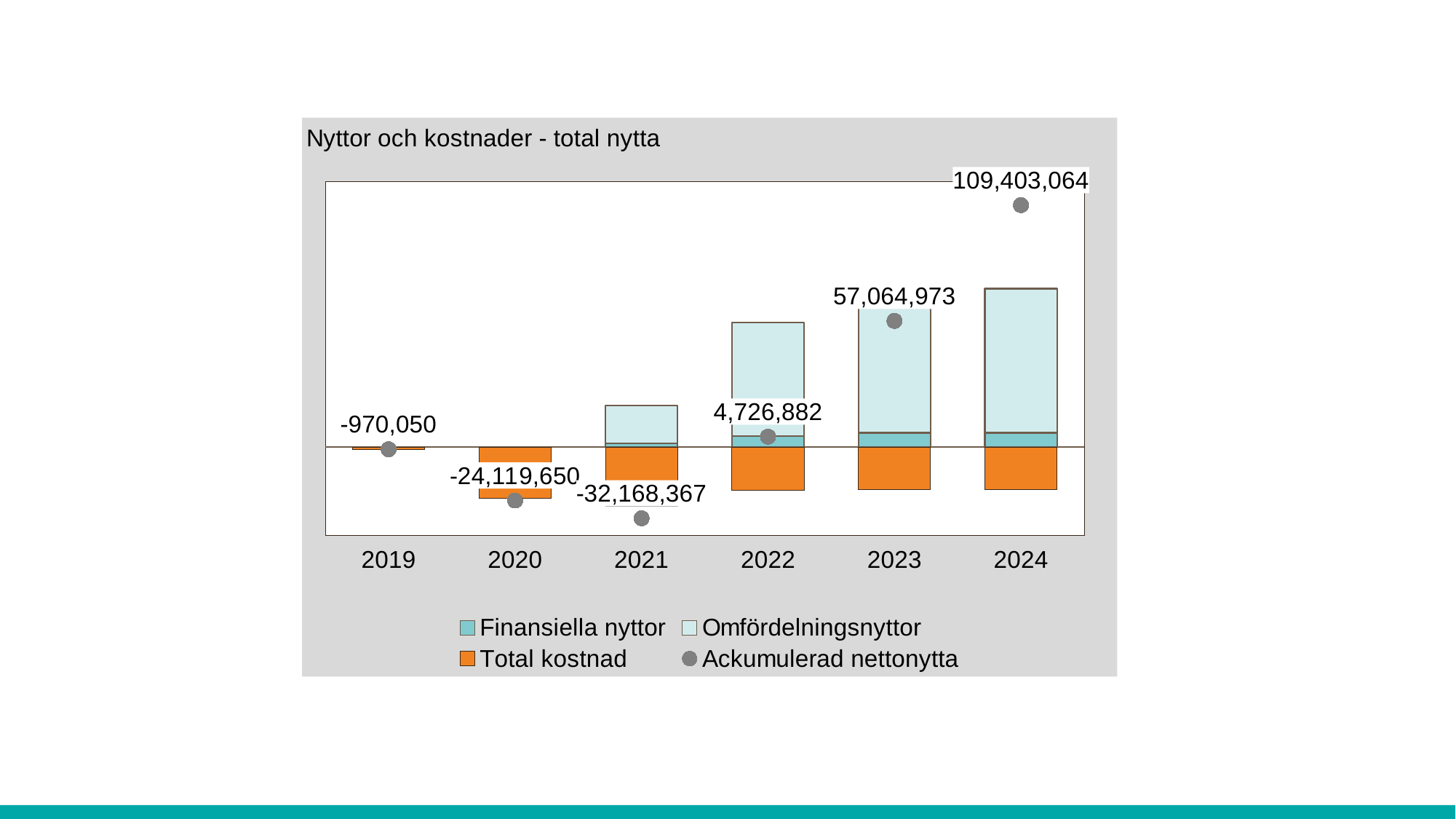
What is the value of Ackumulerad nettonytta for 2024? 109,403,064 What kind of chart is this? Stacked bar chart with a point series What is the value of Ackumulerad nettonytta for 2022? 4,726,882 What is the title of the chart? Nyttor och kostnader - total nytta What is the value of Ackumulerad nettonytta for 2019? -970,050 How many years are shown on the x axis? 6 How many series does the legend list? 4 In which year is Ackumulerad nettonytta highest? 2024 Which year has the larger Ackumulerad nettonytta, 2020 or 2022? 2022 What is the value of Ackumulerad nettonytta for 2021? -32,168,367 In which year is Ackumulerad nettonytta lowest? 2021 What is the difference between Ackumulerad nettonytta in 2024 and in 2023? 52,338,091